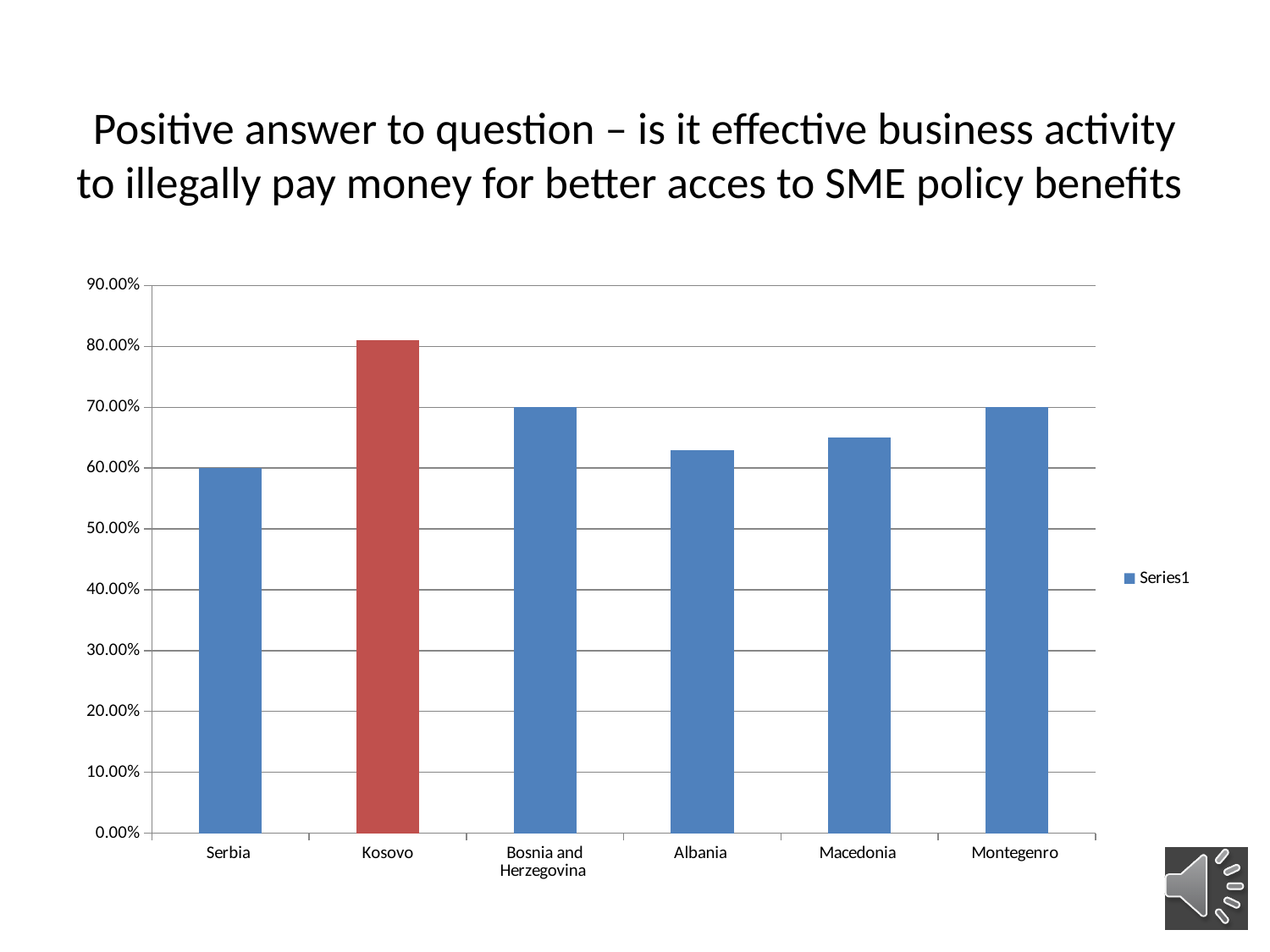
What kind of chart is shown on the slide? bar chart What is the value for Serbia? 60.00% Which country has the highest value in the chart? Kosovo Which is larger, the value for Kosovo or the value for Serbia? Kosovo Is the value for Kosovo greater or less than 70.00%? greater Which country has the lowest value in the chart? Serbia Is the value for Albania greater or less than 70.00%? less How many countries are shown on the x axis of the chart? 6 What is the value for Montegenro? 70.00% What is the value for Bosnia and Herzegovina? 70.00% How many series does the legend list? 1 Which bar in the chart is coloured red rather than blue? Kosovo